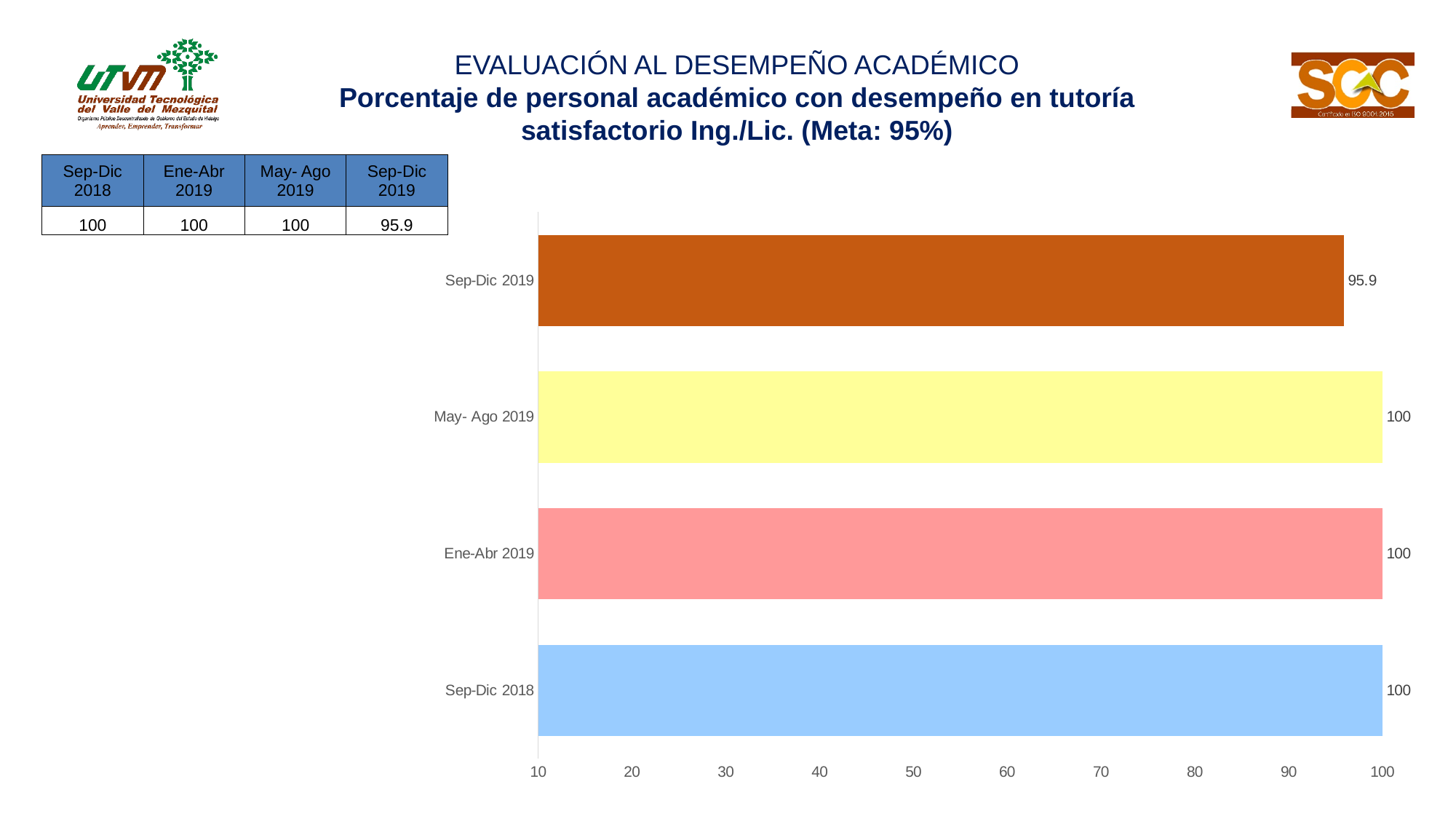
What is the value for May- Ago 2019? 100 What is the value for Sep-Dic 2019? 95.9 How many periods are plotted in the chart? 4 How many periods have a value of 100? 3 What is the value for Sep-Dic 2018? 100 What is the difference between the value for Ene-Abr 2019 and the value for Sep-Dic 2019? 4.1 Which period has the lowest value? Sep-Dic 2019 Which is larger, the value for Sep-Dic 2018 or the value for Sep-Dic 2019? Sep-Dic 2018 What kind of chart is shown on the slide? bar chart What is the target (Meta) stated in the chart title? 95% Is the value for Sep-Dic 2019 greater or less than 90? greater What colour is the bar for Sep-Dic 2019? orange-brown